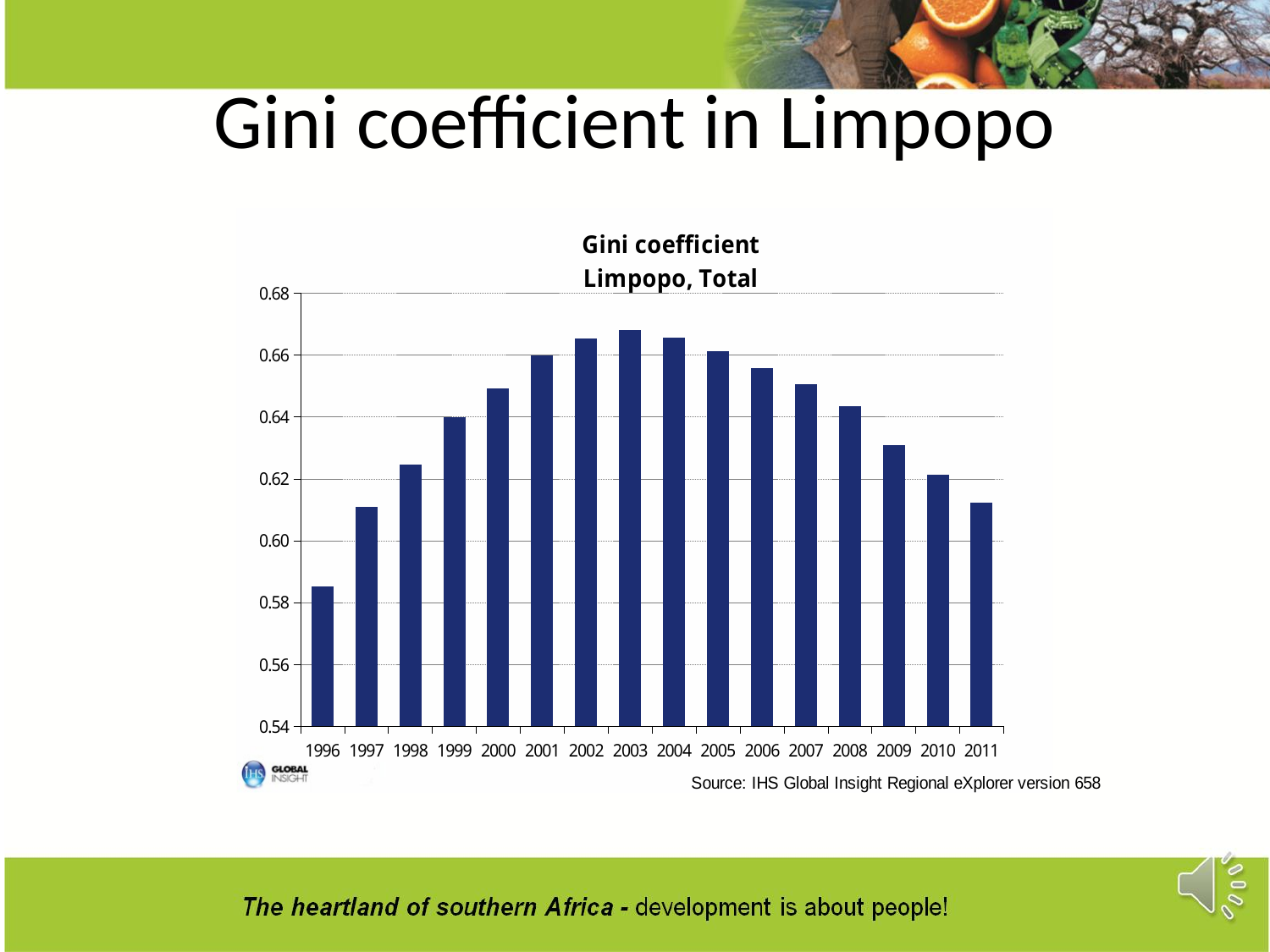
How does the Gini coefficient change from 2003 to 2011? It falls Which year has the lowest Gini coefficient in the chart? 1996 What kind of chart is shown on the slide? bar chart Is the Gini coefficient for 2011 greater or less than 0.60? greater Is the Gini coefficient for 2006 greater or less than 0.66? less What is the title of the chart? Gini coefficient Limpopo, Total How many years are plotted on the x axis of the chart? 16 Is the Gini coefficient for 1996 greater or less than 0.60? less Which year has the larger Gini coefficient, 1996 or 2011? 2011 Which year has the larger Gini coefficient, 1997 or 2010? 2010